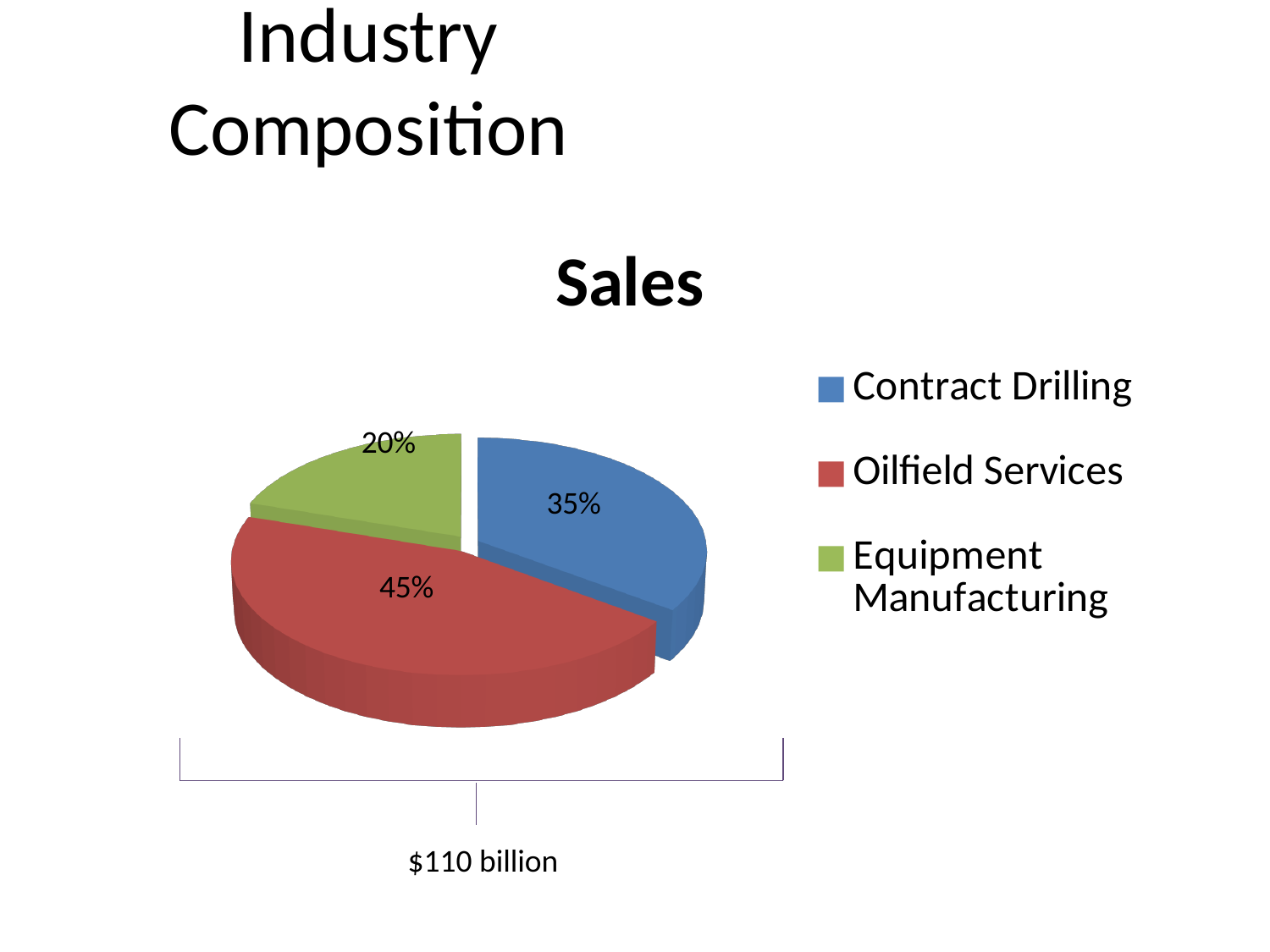
Which has a larger share of sales, Contract Drilling or Equipment Manufacturing? Contract Drilling What colour represents Oilfield Services in the chart? red What share of sales does Contract Drilling account for? 35% What type of chart is shown on the slide? pie chart Which segment has the largest share of sales? Oilfield Services What is the title of the chart? Sales Which segment has the smallest share of sales? Equipment Manufacturing What is the difference in percentage points between the Oilfield Services and Contract Drilling shares? 10 percentage points How many segments does the pie chart have? 3 What share of sales does Oilfield Services account for? 45% What share of sales does Equipment Manufacturing account for? 20% What total sales figure is shown beneath the pie chart? $110 billion